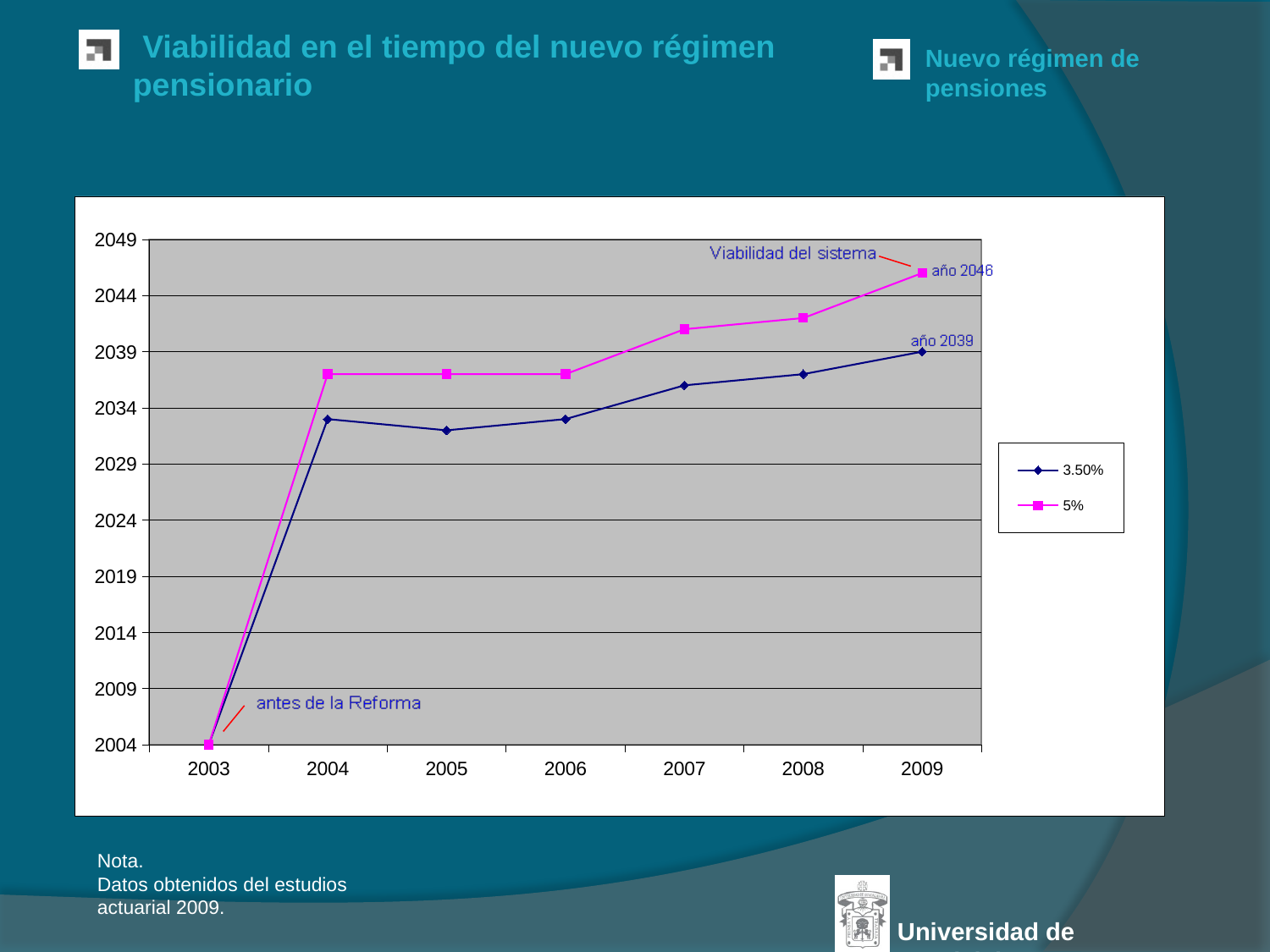
Is the value of the 5% series in 2004 greater or less than 2034? greater What kind of chart is shown on the slide? line chart Is the value of the 3.50% series in 2005 greater or less than 2034? less What value does the 3.50% series reach in 2009? 2039 What is the value of both series in 2003? 2004 For the 3.50% series, in which year is the value highest? 2009 What value does the 5% series reach in 2009? 2046 What are the two entries listed in the legend? 3.50% and 5% What is the difference between the 5% series and the 3.50% series in 2009? 7 How many series does the legend list? 2 How many years are shown along the x axis? 7 In 2009, which series has the higher value, 3.50% or 5%? 5%